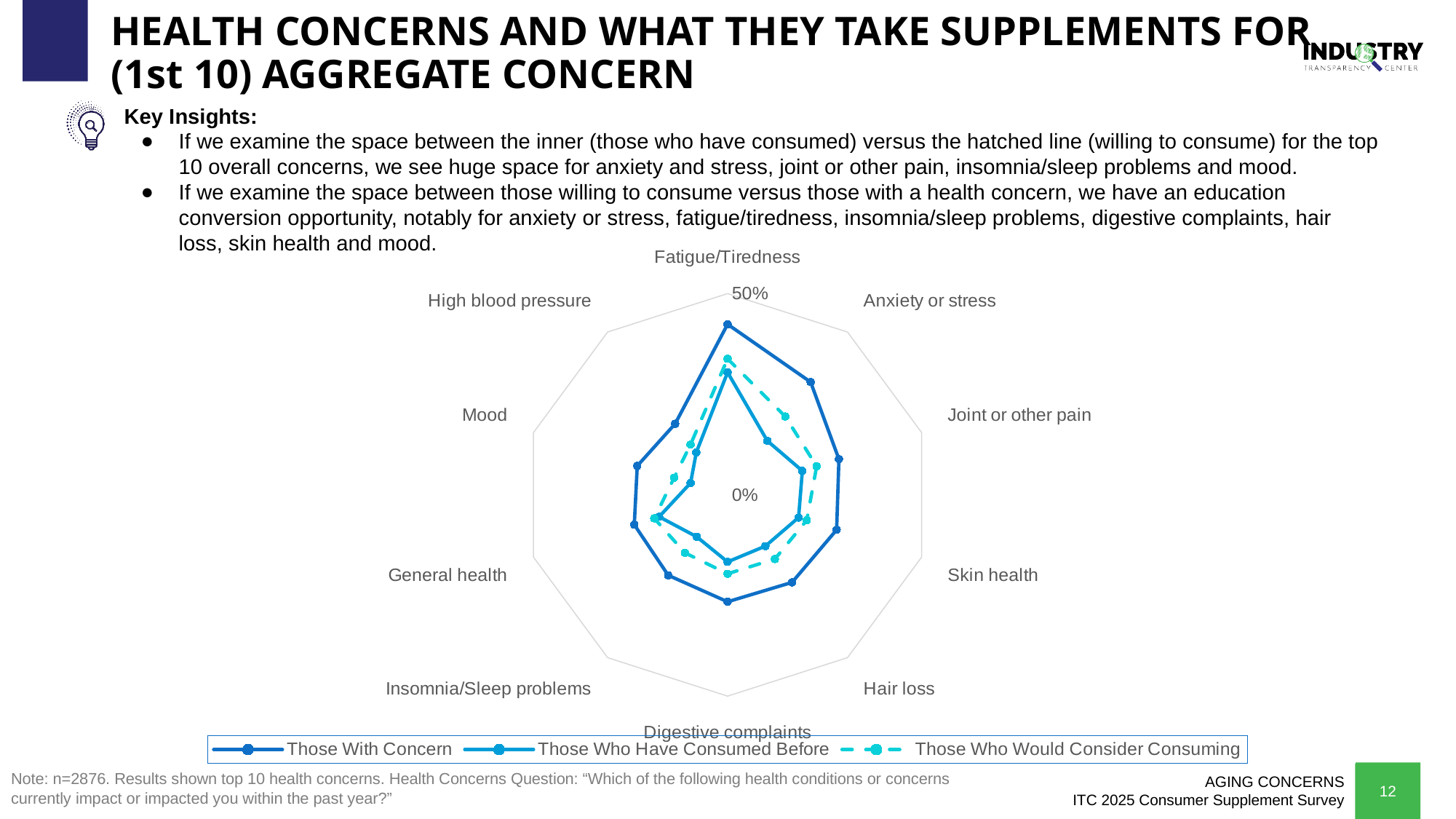
Which series is drawn with a dashed line in the radar chart? Those Who Would Consider Consuming How many series does the legend of the radar chart list? 3 How many health concern categories are plotted on the radar chart? 10 For the Mood category, which series has the larger value: Those With Concern or Those Who Have Consumed Before? Those With Concern Is the value for Fatigue/Tiredness in the series Those With Concern greater or less than 50%? less What is the outermost percentage value labelled on the radar chart's axis? 50% For the series Those With Concern, which category has the highest value? Fatigue/Tiredness For Those With Concern, which is larger: the value for Fatigue/Tiredness or the value for Hair loss? Fatigue/Tiredness What kind of chart is shown on the slide? Radar chart For the series Those Who Have Consumed Before, which category has the highest value? Fatigue/Tiredness For the Anxiety or stress category, which series has the larger value: Those Who Would Consider Consuming or Those Who Have Consumed Before? Those Who Would Consider Consuming For the series Those Who Would Consider Consuming, which category has the highest value? Fatigue/Tiredness